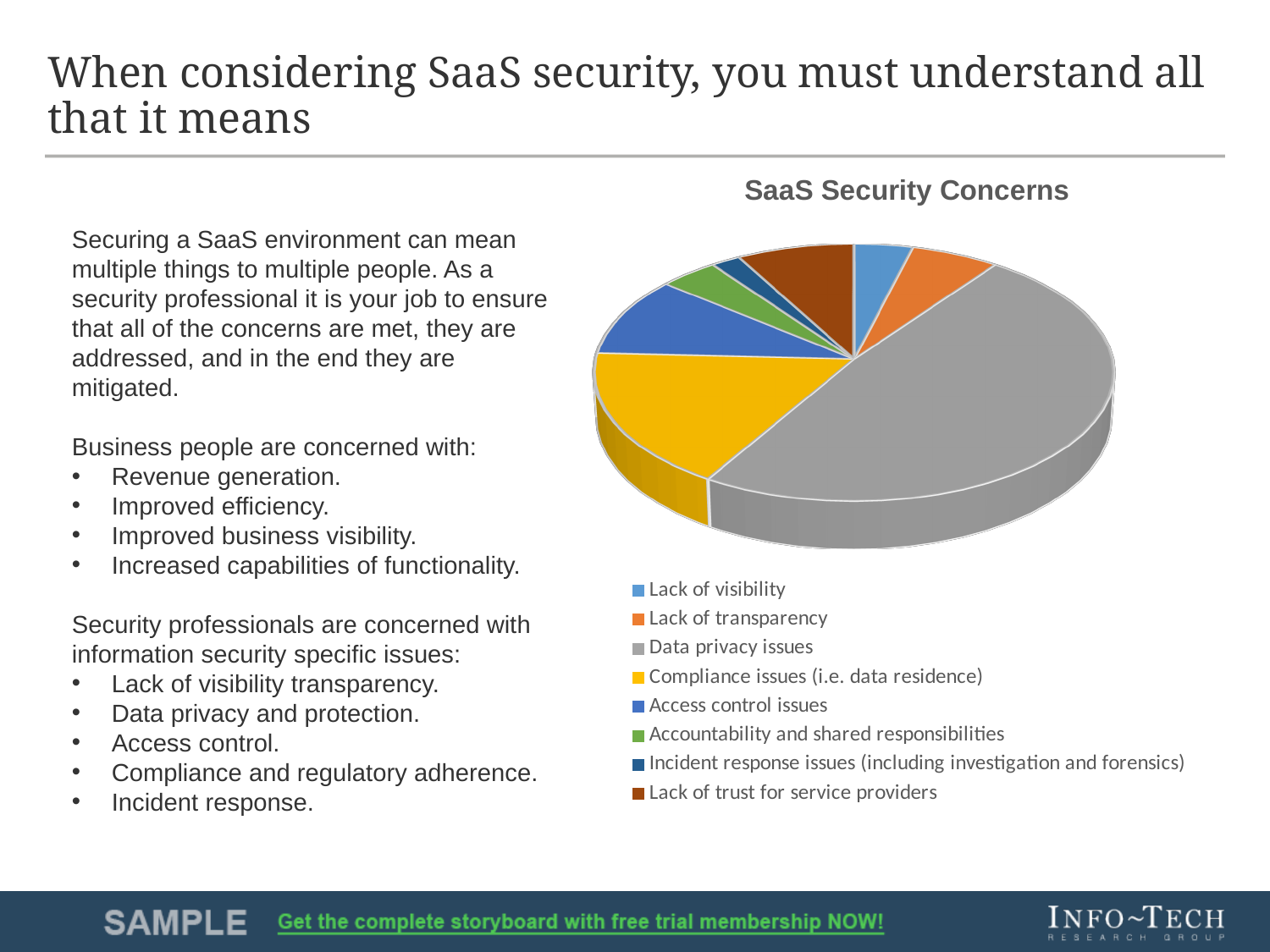
How many categories does the pie chart's legend list? 8 Which slice is larger: Data privacy issues or Lack of trust for service providers? Data privacy issues Which slice is larger: Access control issues or Lack of visibility? Access control issues What colour is the Data privacy issues slice? Gray Which category has the largest slice of the pie? Data privacy issues Which slice is larger: Data privacy issues or Compliance issues (i.e. data residence)? Data privacy issues Which category is the second largest slice of the pie? Compliance issues (i.e. data residence) What kind of chart is shown on the slide? Pie chart What is the title of the chart? SaaS Security Concerns